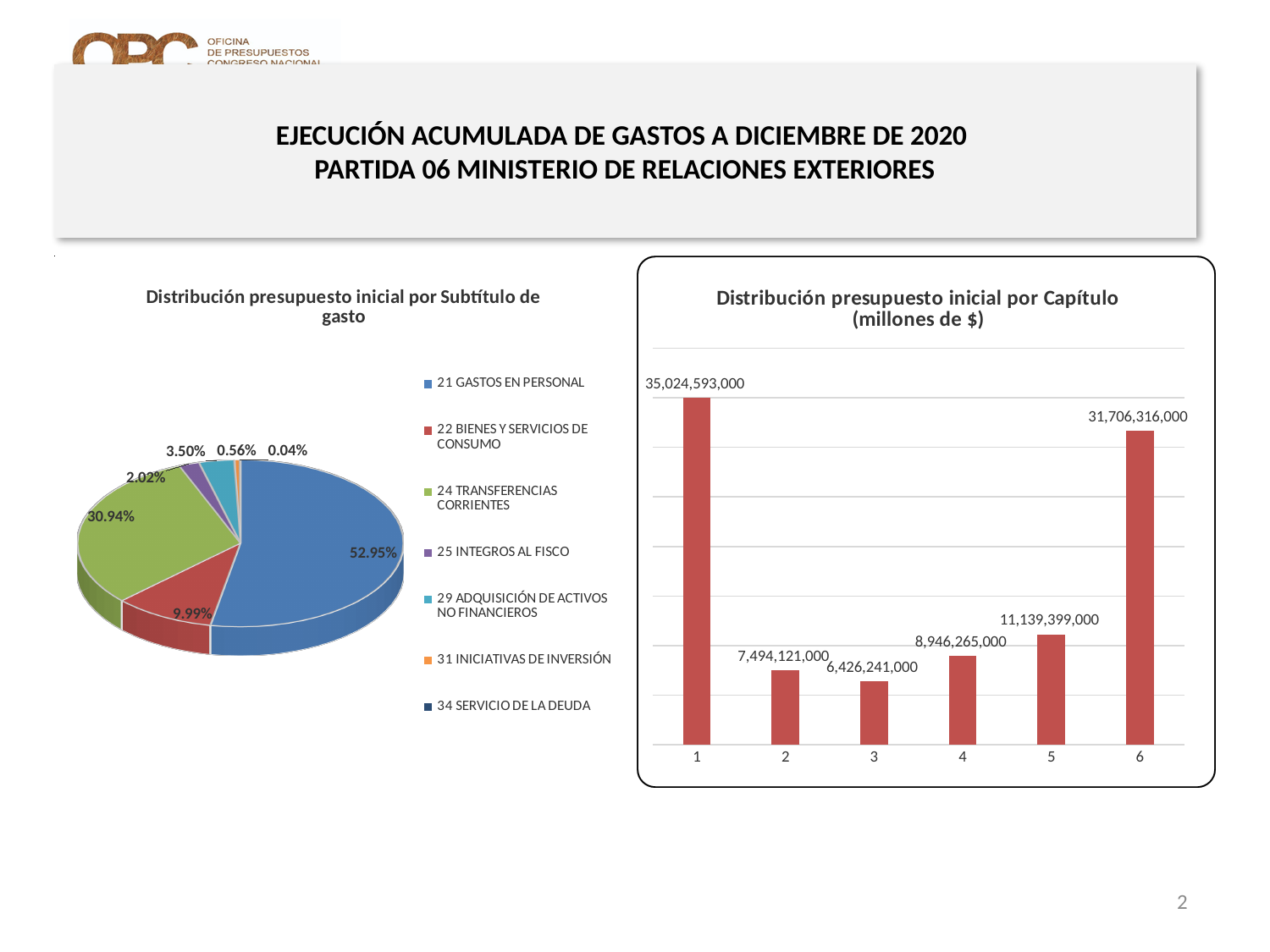
In the pie chart 'Distribución presupuesto inicial por Subtítulo de gasto', which category has the smallest slice? 34 SERVICIO DE LA DEUDA In the pie chart 'Distribución presupuesto inicial por Subtítulo de gasto', what share does '24 TRANSFERENCIAS CORRIENTES' have? 30.94% In the chart 'Distribución presupuesto inicial por Capítulo (millones de $)', what is the difference between the values for category 5 and category 4? 2,193,134,000 In the pie chart 'Distribución presupuesto inicial por Subtítulo de gasto', which category has the largest slice? 21 GASTOS EN PERSONAL In the chart 'Distribución presupuesto inicial por Capítulo (millones de $)', which category has the lowest value? 3 In the chart 'Distribución presupuesto inicial por Capítulo (millones de $)', what is the value for category 1? 35,024,593,000 In the chart 'Distribución presupuesto inicial por Capítulo (millones de $)', what is the value for category 6? 31,706,316,000 In the pie chart 'Distribución presupuesto inicial por Subtítulo de gasto', what share does '21 GASTOS EN PERSONAL' have? 52.95% In the pie chart 'Distribución presupuesto inicial por Subtítulo de gasto', how many categories does the legend list? 7 In the pie chart 'Distribución presupuesto inicial por Subtítulo de gasto', what is the difference in percentage points between '21 GASTOS EN PERSONAL' and '24 TRANSFERENCIAS CORRIENTES'? 22.01% In the chart 'Distribución presupuesto inicial por Capítulo (millones de $)', which has the larger value, category 2 or category 3? 2 What kind of chart is 'Distribución presupuesto inicial por Capítulo (millones de $)'? bar chart